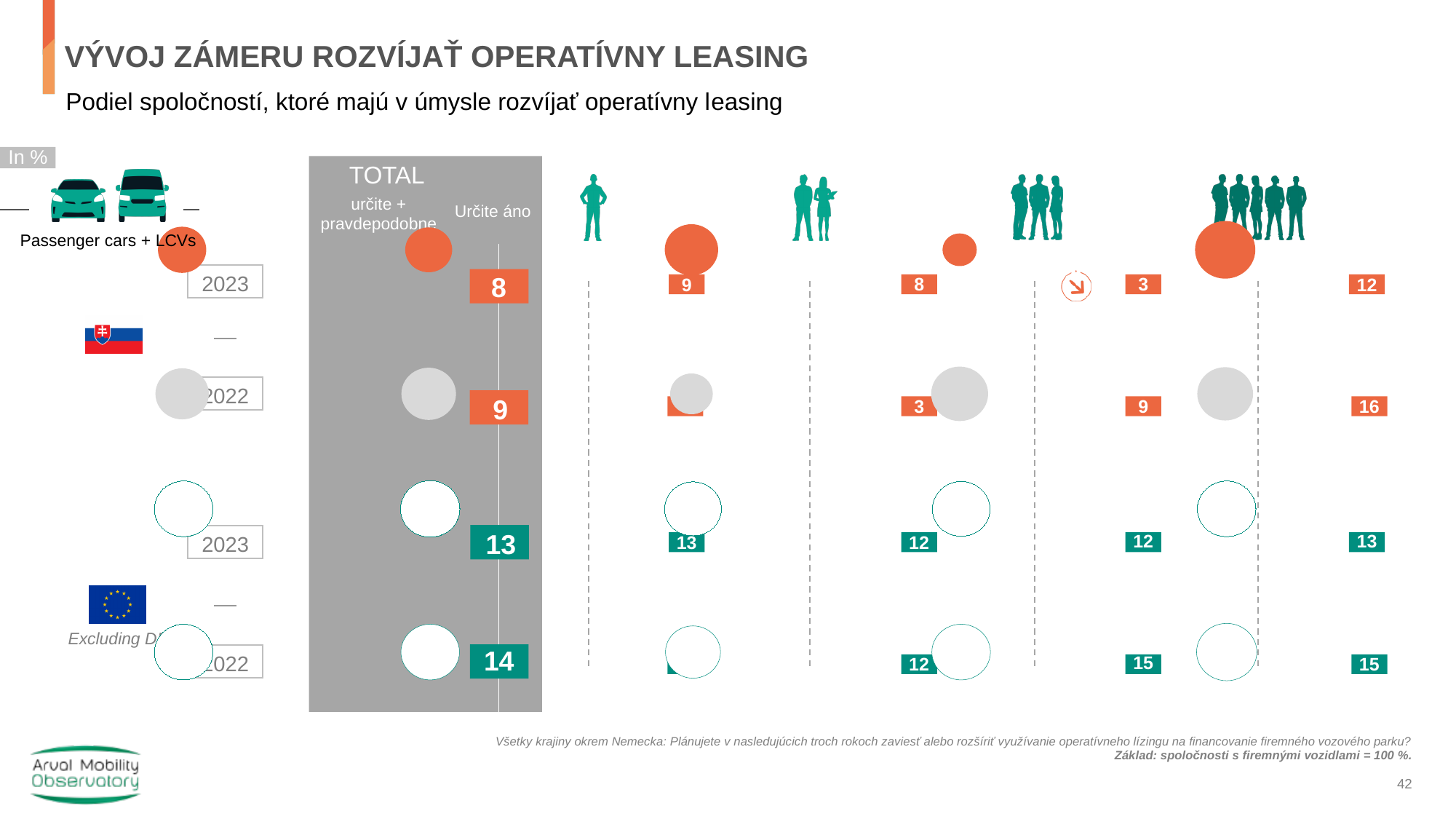
In the TOTAL column, which Slovakia year has the larger 'Určite áno' value, 2022 or 2023? 2022 In the TOTAL column, what is the 'Určite áno' value for Slovakia in 2022? 9 In the TOTAL column, what is the 'Určite áno' value for Slovakia in 2023? 8 Did the TOTAL 'Určite áno' value for Slovakia rise or fall from 2022 to 2023? fall In the Slovakia 2023 row, what is the lowest 'Určite áno' value shown across the company-size segments? 3 In the TOTAL column, what is the 'Určite áno' value for the EU row in 2023? 13 In the TOTAL column, what is the 'Určite áno' value for the EU row in 2022? 14 In the rightmost company-size segment (largest group of people icons), what is the 'Určite áno' value for Slovakia in 2022? 16 In the Slovakia 2023 row, what is the highest 'Určite áno' value shown across the company-size segments? 12 In what unit are the values on the chart expressed, according to the label at the top left? In % In the TOTAL column, what is the difference between the EU 2023 'Určite áno' value and the Slovakia 2023 'Určite áno' value? 5 How many year rows (country-year combinations) are shown on the chart? 4